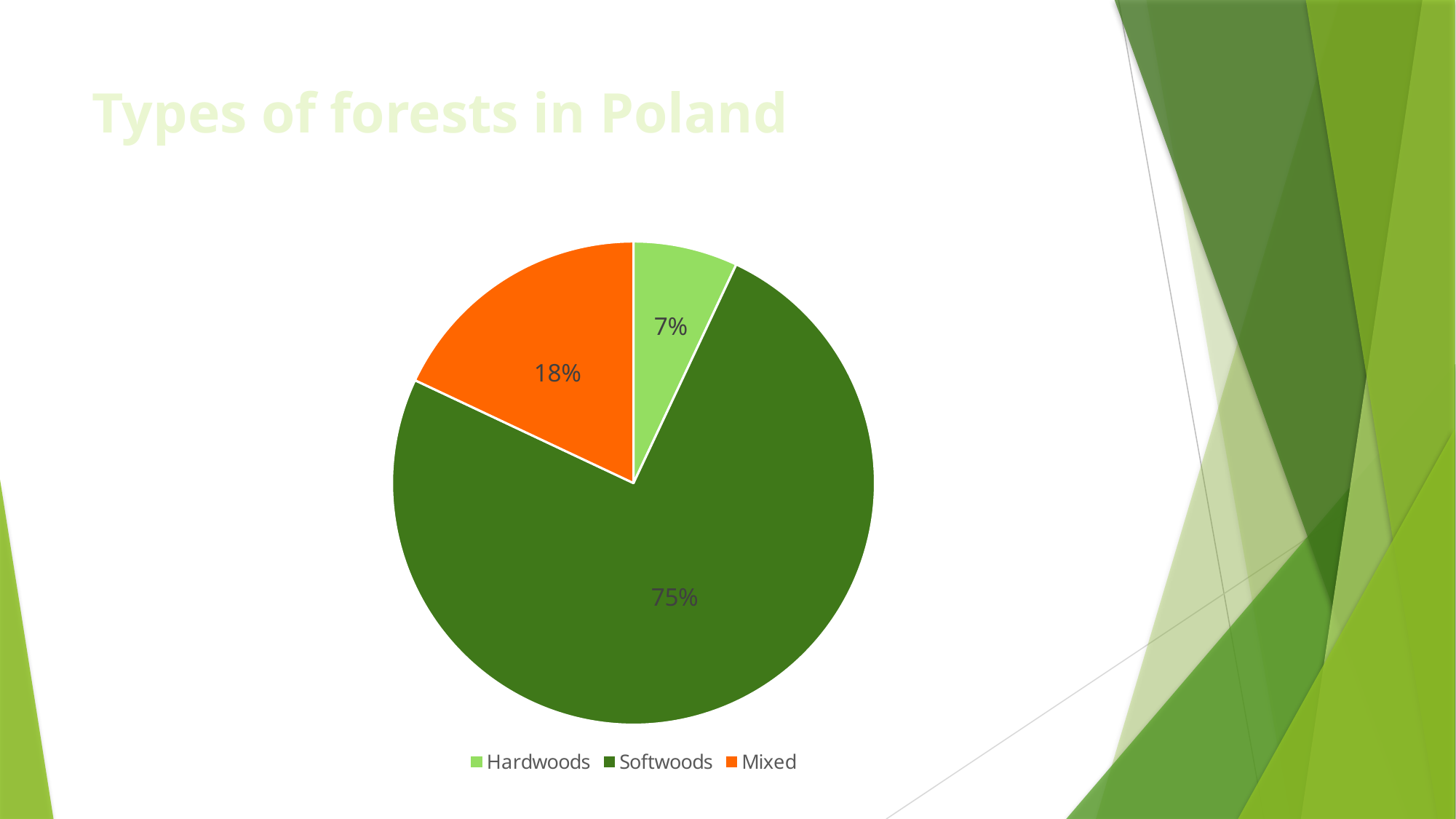
What is the difference in percentage points between Softwoods and Mixed? 57 What colour is the Mixed slice in the pie chart? Orange What is the title of the slide containing the chart? Types of forests in Poland Which is larger, the Mixed slice or the Hardwoods slice? Mixed What is the difference in percentage points between Mixed and Hardwoods? 11 What share of the pie does Softwoods represent? 75% What share of the pie does Mixed represent? 18% What type of chart is shown on the slide? Pie chart Which forest type has the smallest slice of the pie? Hardwoods How many categories does the pie chart show? 3 Which forest type has the largest slice of the pie? Softwoods What share of the pie does Hardwoods represent? 7%